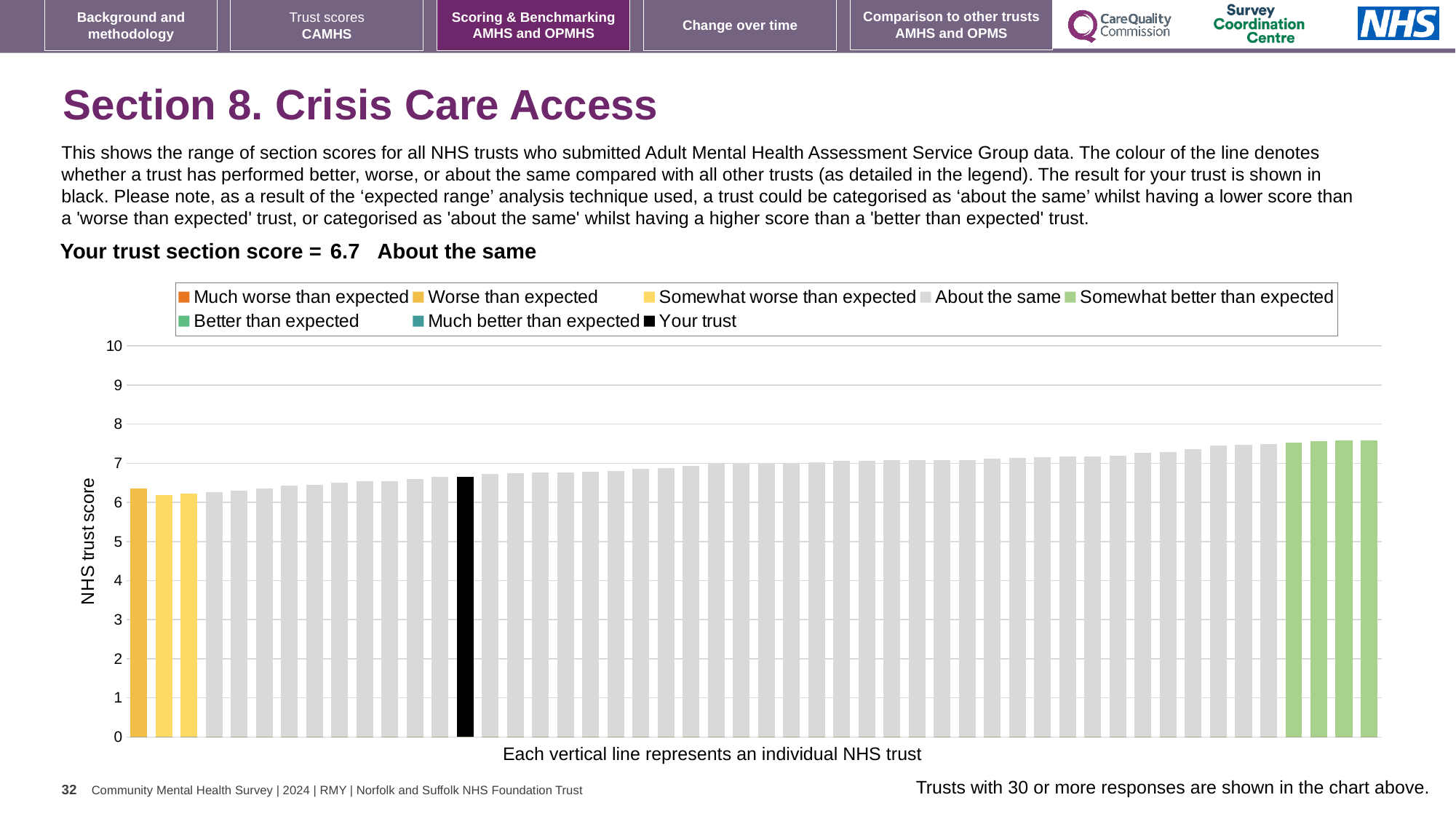
Is the value of the tallest bar in the chart greater or less than 8? less Which category is your trust placed in for this section? About the same What is the section score for your trust shown on the slide? 6.7 Is the value for your trust (the black bar) greater or less than 7? less Is the value of the tallest bar in the chart greater or less than 7? greater Do the bar values rise or fall from left to right along the x axis? Rise What is the label on the vertical axis of the chart? NHS trust score What kind of chart is shown on the slide? Bar chart How many bars are coloured green (somewhat better than expected)? 4 Which is larger: the value for your trust (black bar) or the value of the leftmost bar? Your trust How many entries does the chart legend list? 8